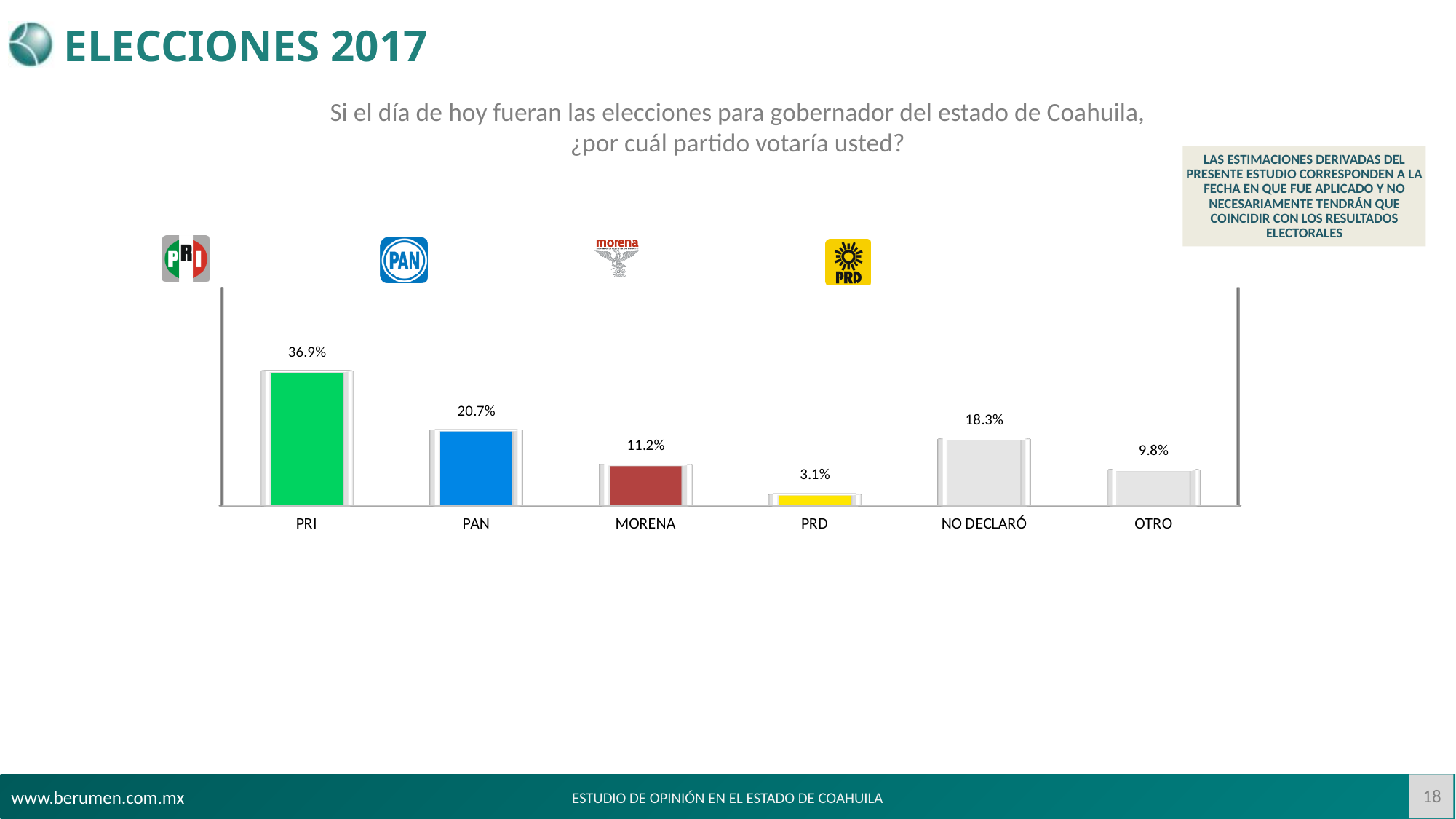
Which category has the lowest percentage in the chart? PRD What percentage of respondents said they would vote for PRI? 36.9% Which is larger, the value for PAN or the value for NO DECLARÓ? PAN What kind of chart is shown on the slide? Bar chart Which party has the highest percentage in the chart? PRI What percentage is shown for MORENA? 11.2% What is the value for NO DECLARÓ? 18.3% What colour is the bar for PRI? Green What is the difference between the PRI and PAN percentages? 16.2% How many categories are shown in the chart? 6 What is the value shown for PAN? 20.7% What is the difference between the NO DECLARÓ and OTRO percentages? 8.5%